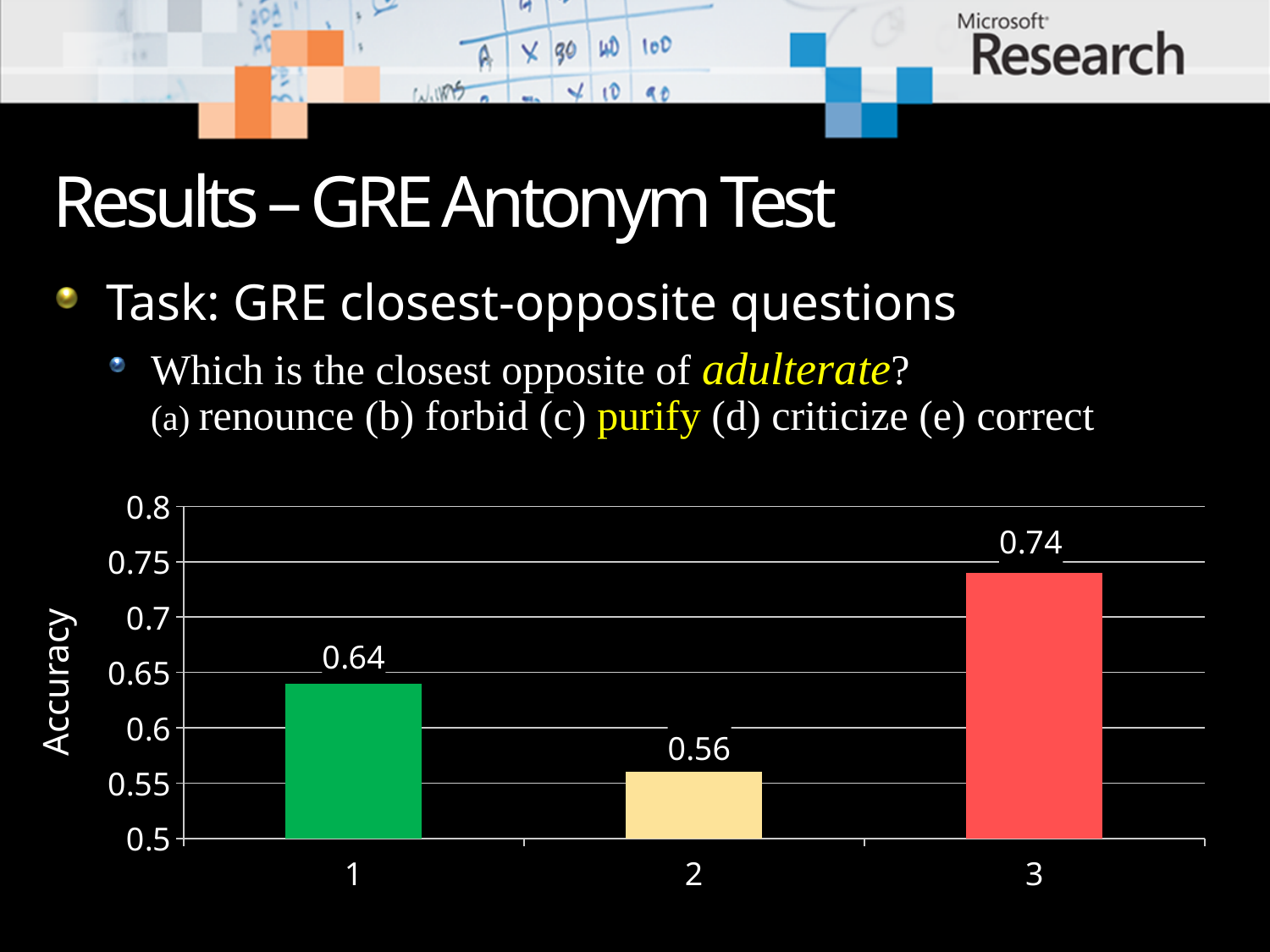
What is the accuracy value for category 3? 0.74 What is the accuracy value for category 2? 0.56 How many categories are shown on the x axis of the chart? 3 Which category has the highest accuracy? 3 Which has a higher accuracy, category 1 or category 2? 1 Is the accuracy for category 3 greater or less than 0.7? greater What type of chart is shown on the slide? bar chart What is the label of the y axis of the chart? Accuracy What is the difference in accuracy between category 3 and category 1? 0.1 What is the accuracy value for category 1? 0.64 Which category has the lowest accuracy? 2 What is the difference in accuracy between category 1 and category 2? 0.08